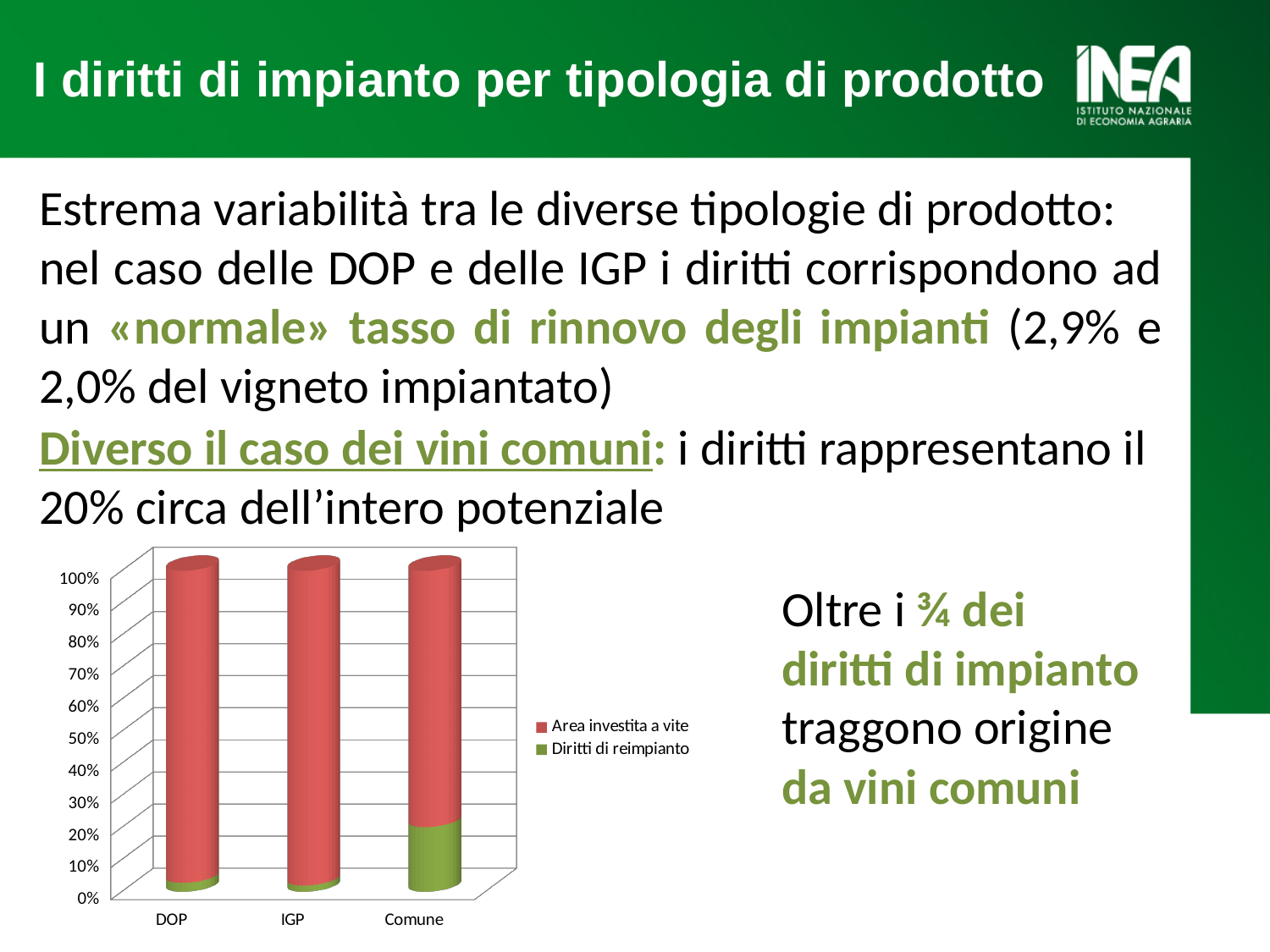
Which has a larger 'Diritti di reimpianto' share, Comune or DOP? Comune Is the 'Diritti di reimpianto' share for Comune greater or less than 10%? greater How many categories are shown on the x axis of the chart? 3 Which category has the largest share for 'Diritti di reimpianto'? Comune What is the total height of each stacked bar in the chart? 100% Is the 'Diritti di reimpianto' share for DOP greater or less than 10%? less Is the 'Diritti di reimpianto' share for Comune greater or less than 30%? less Which colour represents 'Area investita a vite' in the chart legend? Red What kind of chart is shown on the slide? Stacked bar chart How many series does the chart legend list? 2 What is the highest value shown on the chart's vertical axis? 100%